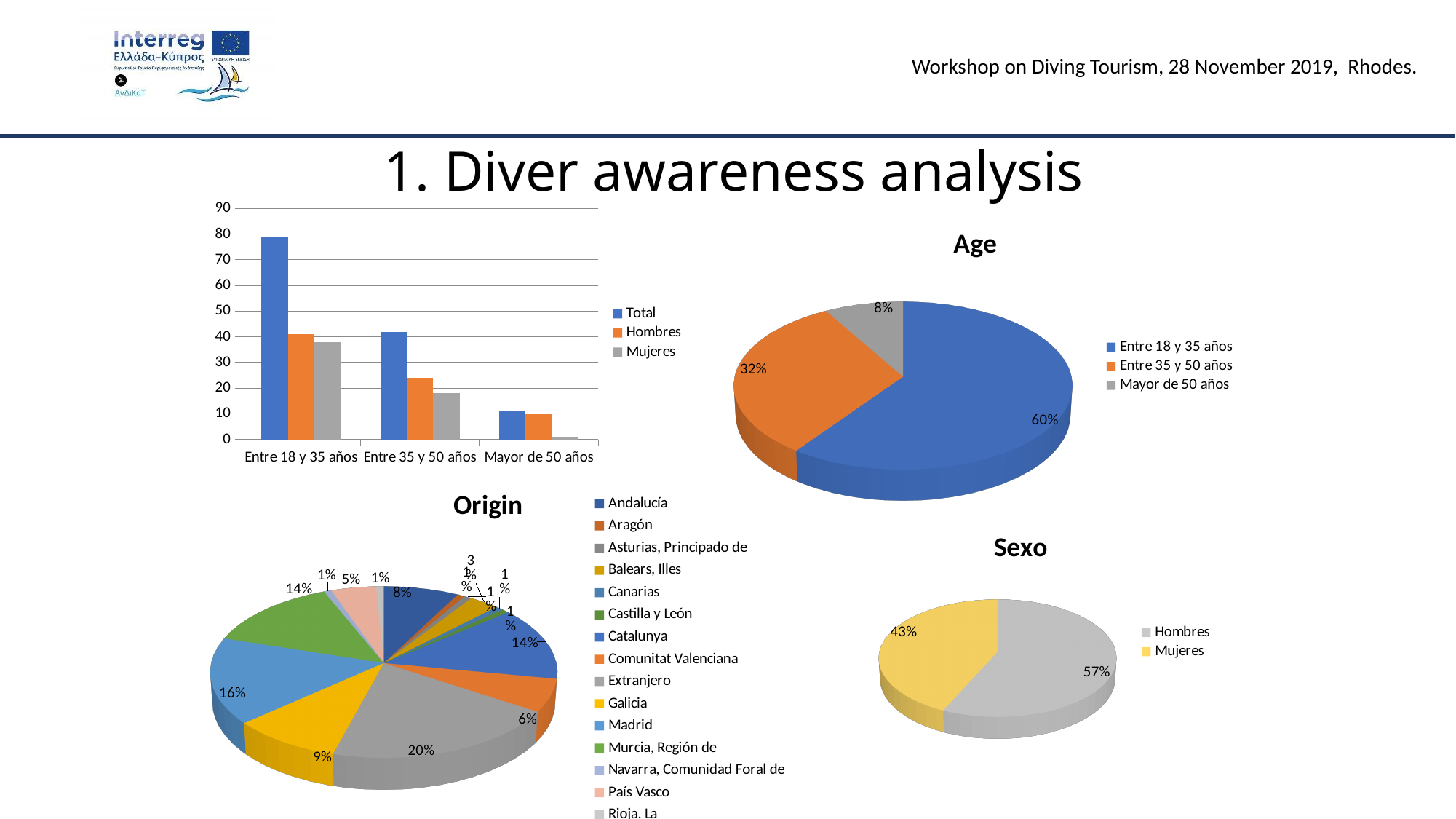
In the Age pie chart, what percentage is shown for Entre 18 y 35 años? 60% How many series does the legend of the Sexo pie chart list? 2 In the Age pie chart, what percentage is shown for Mayor de 50 años? 8% What type of chart is the chart at the top left of the slide? bar chart In the bar chart at the top left, is the Mujeres value for Entre 35 y 50 años greater or less than 20? less In the Age pie chart, which age group has the largest share? Entre 18 y 35 años In the Sexo pie chart, which group has the larger share, Hombres or Mujeres? Hombres In the Age pie chart, what is the difference in percentage points between Entre 35 y 50 años and Mayor de 50 años? 24 In the Origin pie chart, what percentage is shown for Extranjero? 20% In the bar chart at the top left, is the Total value for Entre 18 y 35 años greater or less than 70? greater In the Origin pie chart, what percentage is shown for Madrid? 16% In the Sexo pie chart, what percentage is shown for Mujeres? 43%